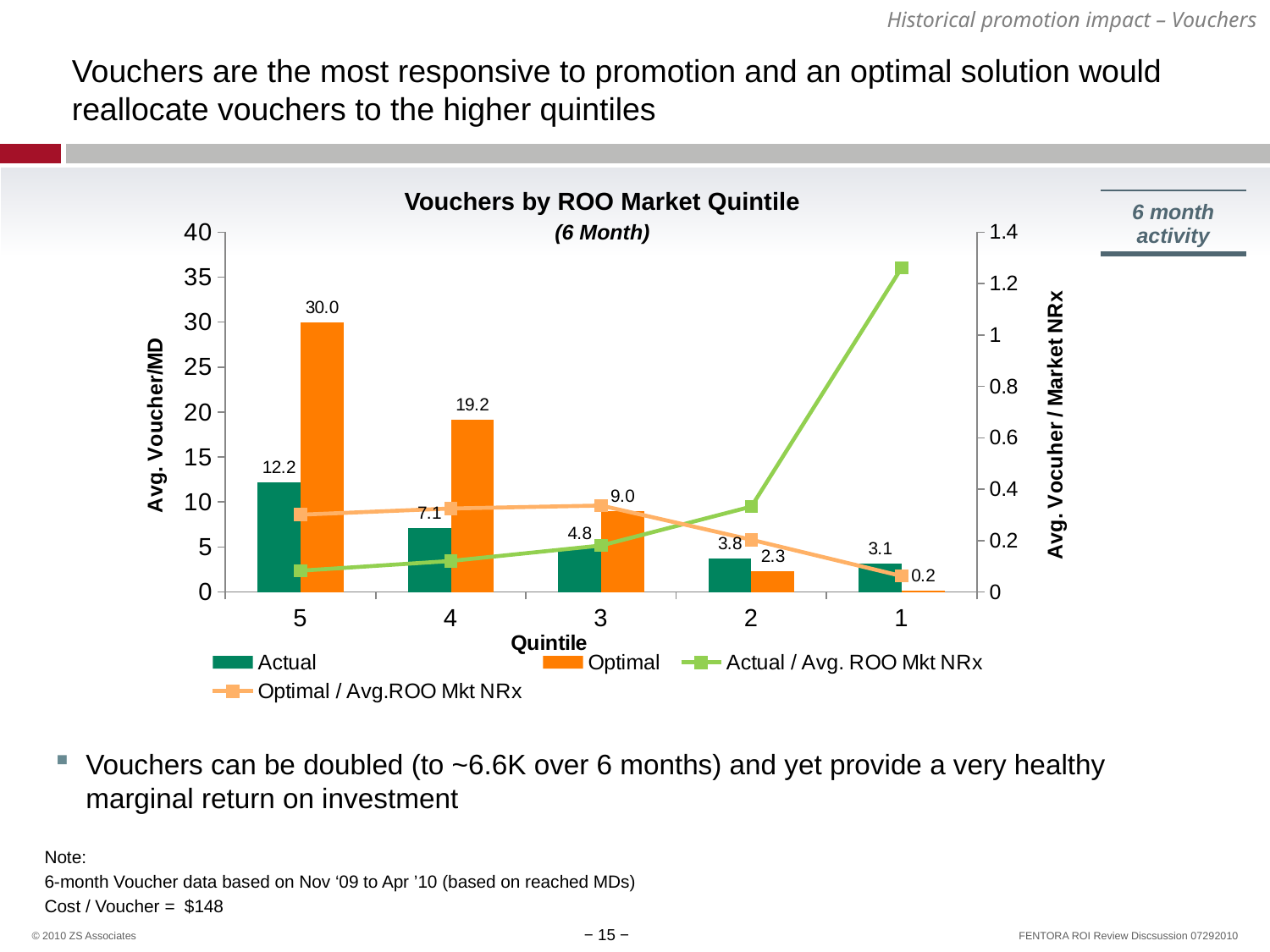
What kind of chart is shown? Combined bar and line chart How many series does the legend list? 4 What is the title of the chart? Vouchers by ROO Market Quintile (6 Month) For quintile 2, which is larger, the Actual or the Optimal value? Actual What is the Actual value for quintile 3? 4.8 What is the Optimal value for quintile 5? 30.0 Which quintile has the highest Optimal value? 5 Do the Optimal bar values rise or fall moving from quintile 5 to quintile 1? fall What is the difference between the Optimal and Actual values for quintile 5? 17.8 Which quintile has the lowest Actual value? 1 Is the Actual / Avg. ROO Mkt NRx value for quintile 1 greater or less than 1 on the right-hand axis? greater How many quintiles are shown on the x axis? 5